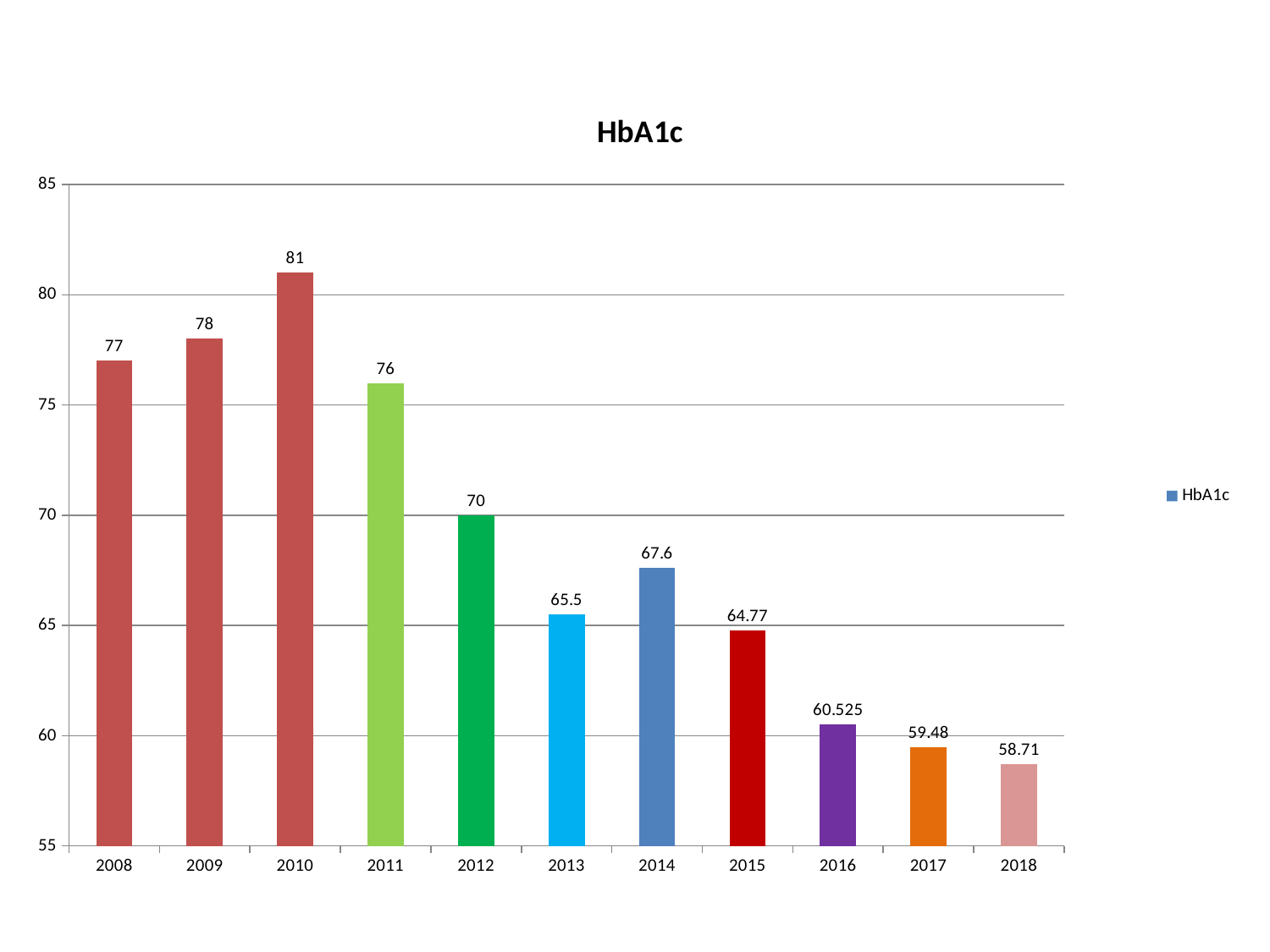
Do the HbA1c values generally rise or fall from 2010 to 2018? fall What is the HbA1c value for 2014? 67.6 What kind of chart is shown on the slide? bar chart Which year has the highest HbA1c value? 2010 What is the HbA1c value for 2010? 81 What is the difference between the HbA1c values for 2008 and 2018? 18.29 Which year has a higher HbA1c value, 2013 or 2015? 2013 Is the HbA1c value for 2017 greater or less than 60? less How many series does the legend list? 1 Which year has the lowest HbA1c value? 2018 What is the HbA1c value for 2016? 60.525 How many years are shown on the x axis? 11